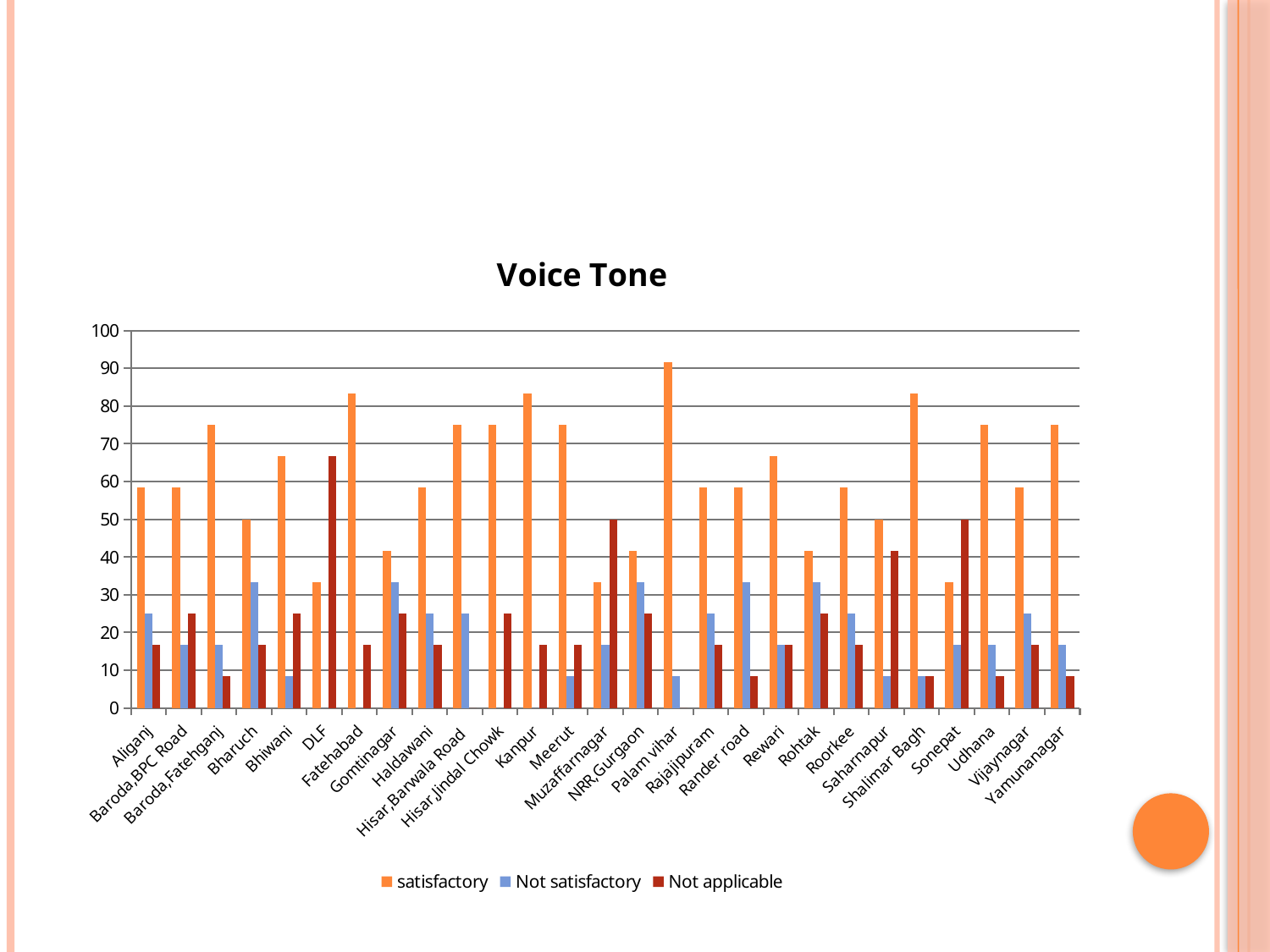
What type of chart is shown on the slide? bar chart Which category has the highest Not applicable value? DLF Is the Not applicable value for Hisar,Jindal Chowk greater or less than 30? less Which is larger, the Not applicable value for DLF or for Muzaffarnagar? DLF Is the Not applicable value for DLF greater or less than 60? greater What is the title of the chart? Voice Tone Is the satisfactory value for Aliganj greater or less than 50? greater How many categories are shown on the x axis? 27 Which category has the highest satisfactory value? Palam vihar How many series does the legend list? 3 Which is larger, the satisfactory value for Palam vihar or for Kanpur? Palam vihar